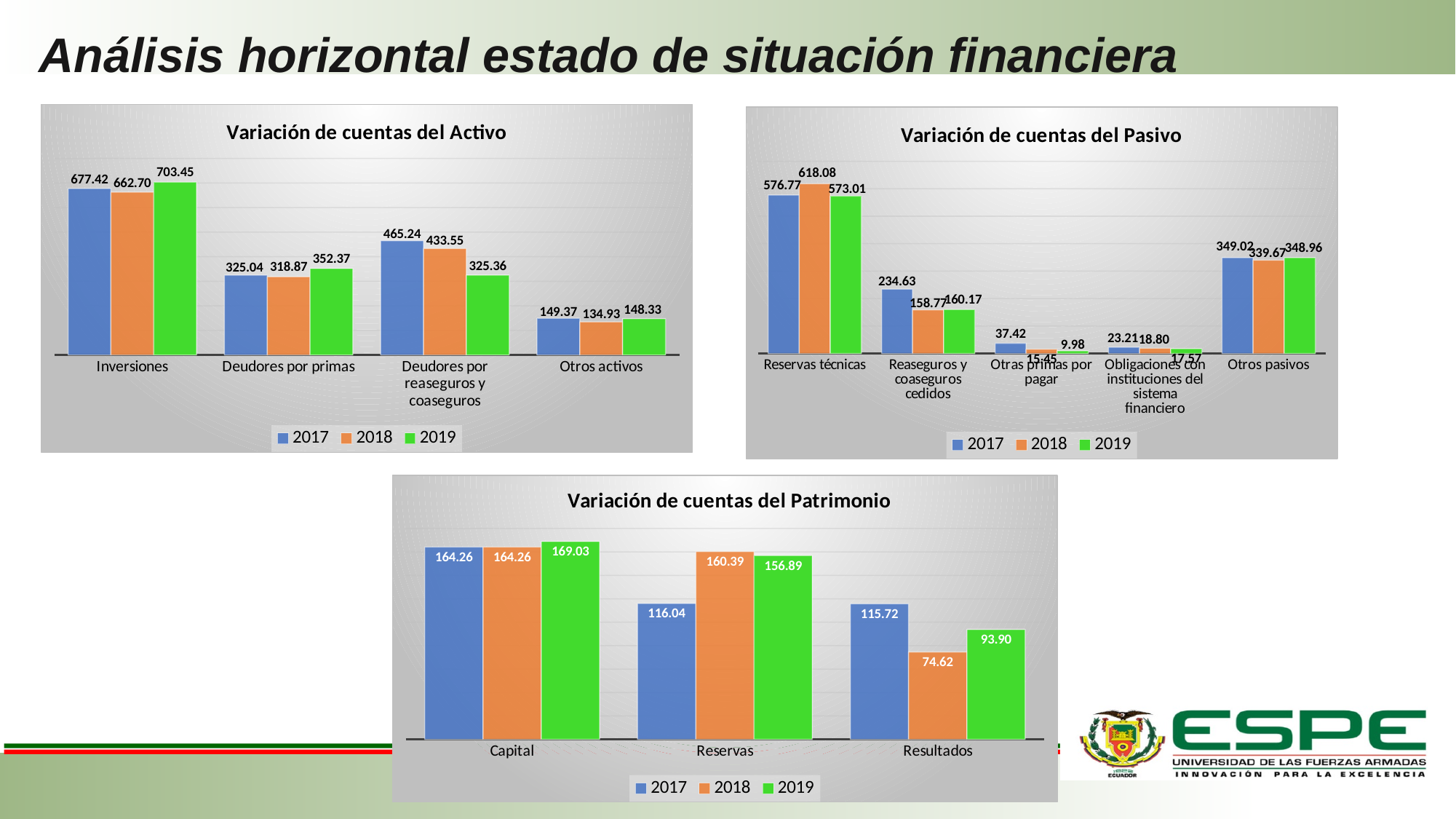
In the 'Variación de cuentas del Pasivo' chart, do the values for Otras primas por pagar rise or fall from 2017 to 2019? fall In the 'Variación de cuentas del Pasivo' chart, is the 2017 value for Reaseguros y coaseguros cedidos larger or smaller than the 2019 value for Otros pasivos? smaller In the 'Variación de cuentas del Patrimonio' chart, what is the difference between the 2018 and 2017 values for Reservas? 44.35 In the 'Variación de cuentas del Patrimonio' chart, what is the 2018 value for Resultados? 74.62 In the 'Variación de cuentas del Activo' chart, how many categories are shown on the x axis? 4 In the 'Variación de cuentas del Activo' chart, what is the 2019 value for Inversiones? 703.45 In the 'Variación de cuentas del Pasivo' chart, which category has the highest 2017 value? Reservas técnicas In the 'Variación de cuentas del Pasivo' chart, what is the 2018 value for Reservas técnicas? 618.08 In the 'Variación de cuentas del Activo' chart, which category has the lowest 2018 value? Otros activos In the 'Variación de cuentas del Activo' chart, what is the difference between the 2017 and 2019 values for Deudores por reaseguros y coaseguros? 139.88 What type of chart is 'Variación de cuentas del Patrimonio'? bar chart How many series does the legend of the 'Variación de cuentas del Patrimonio' chart list? 3